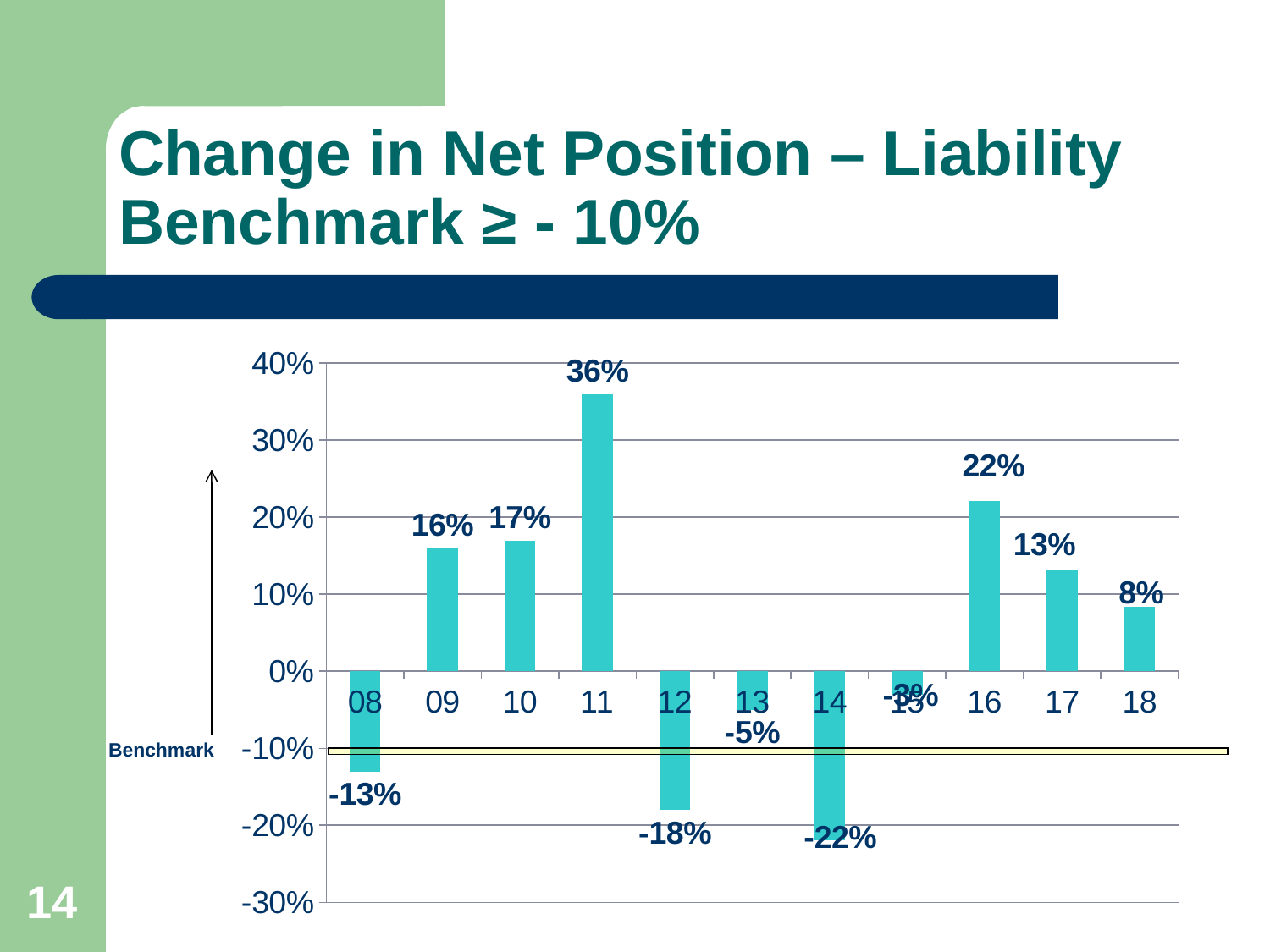
What is the value for 17? 13% What is the value for 08? -13% Is the value for 12 greater or less than -10%? less At what value is the Benchmark line drawn? -10% Which year has the highest value? 11 How many years are shown on the x axis? 11 What kind of chart is shown on the slide? bar chart What is the value for 11? 36% Which is larger, the value for 09 or the value for 10? 10 What is the value for 14? -22% Which year has the lowest value? 14 What is the difference between the values for 16 and 18? 14%